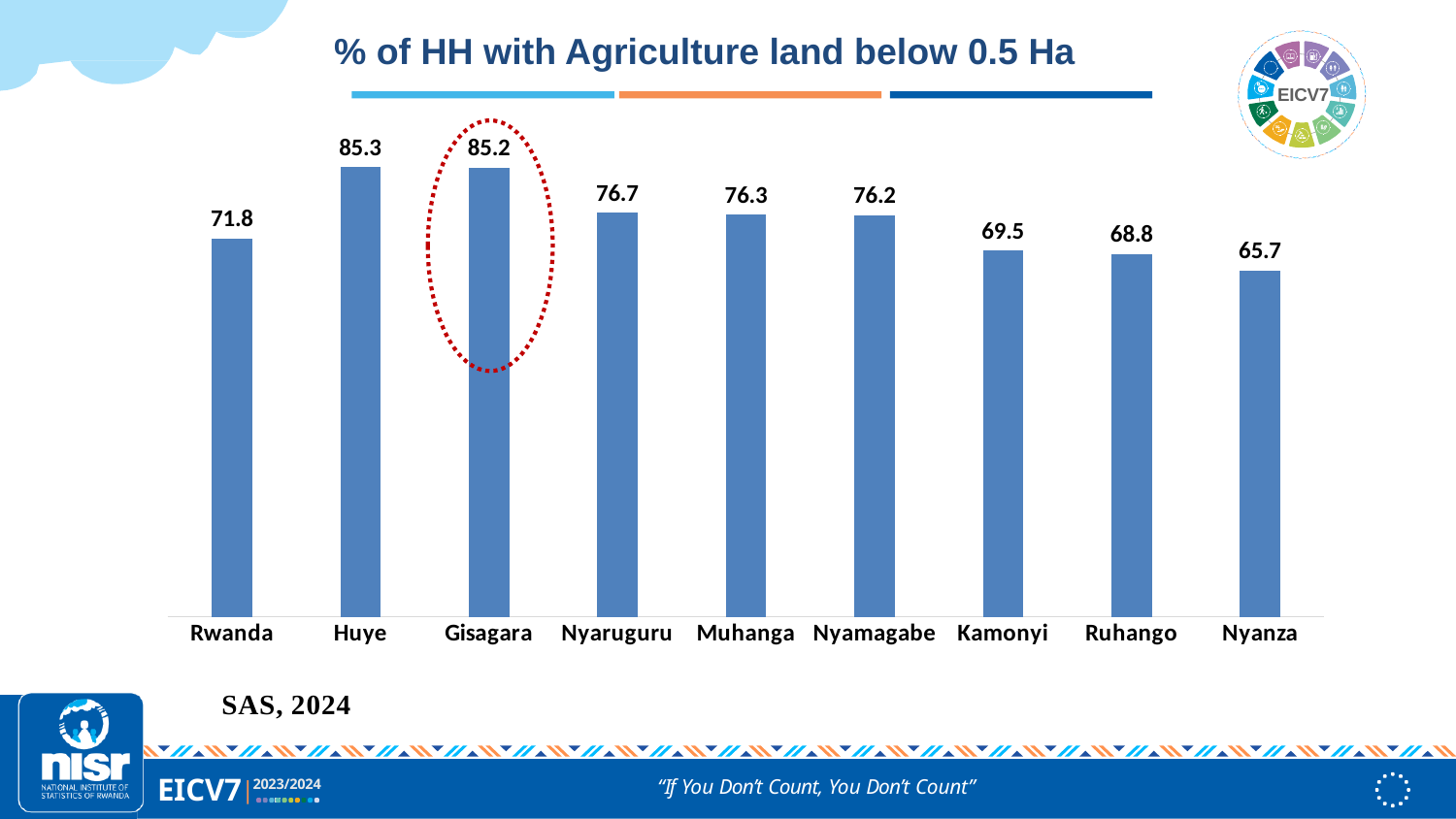
What is the difference between the values for Nyaruguru and Kamonyi? 7.2 What is the value for Nyamagabe? 76.2 What is the difference between the values for Rwanda and Nyanza? 6.1 Which category has the lowest value? Nyanza Which is larger, the value for Rwanda or the value for Nyaruguru? Nyaruguru What is the value for Rwanda? 71.8 What kind of chart is shown on the slide? Bar chart Which is larger, the value for Muhanga or the value for Kamonyi? Muhanga How many categories are shown on the x axis? 9 What is the value for Gisagara? 85.2 What is the value for Ruhango? 68.8 Which category's bar is highlighted with a red dotted circle? Gisagara